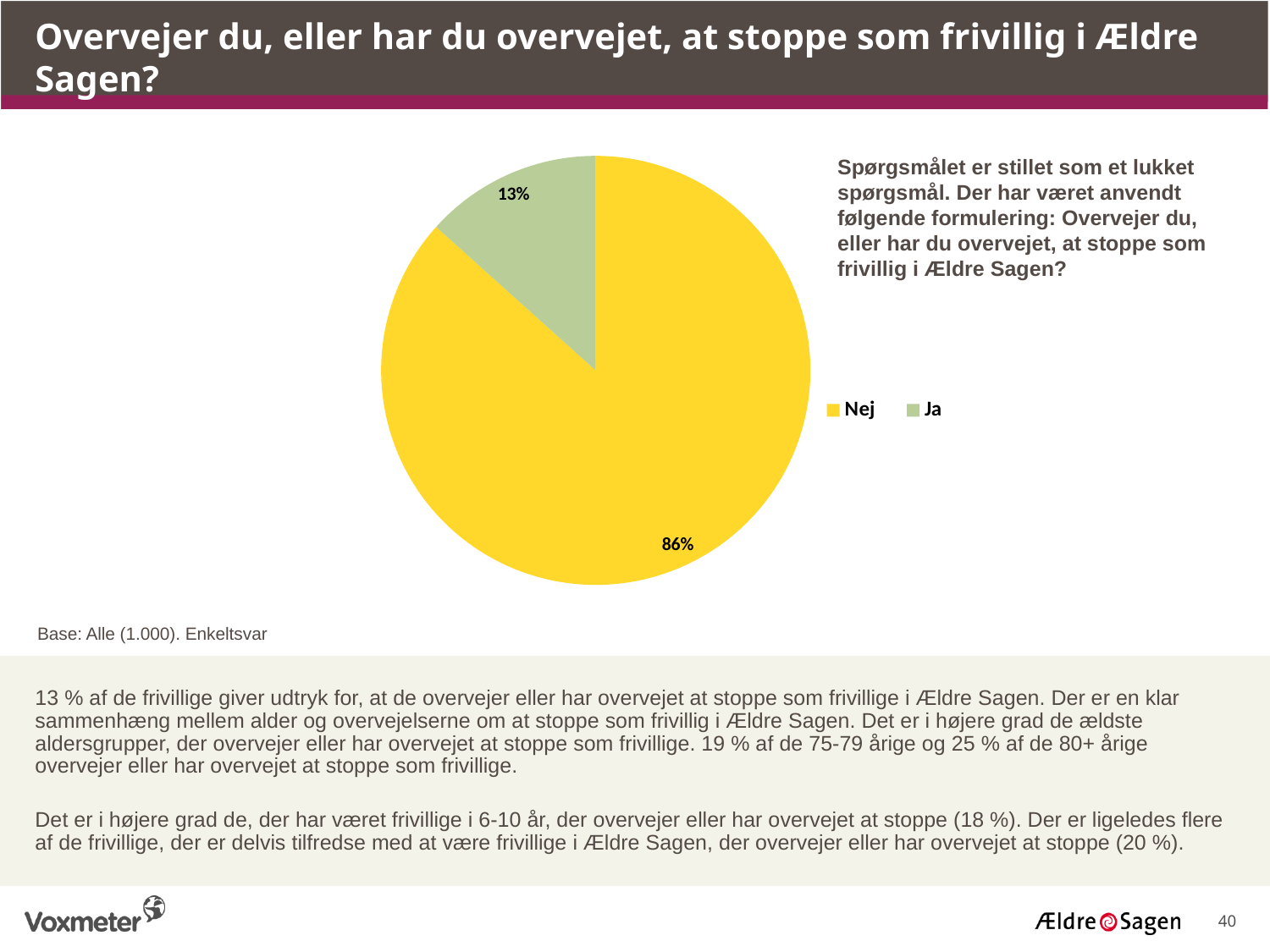
Which slice of the pie is the largest? Nej What share of the pie does the "Nej" slice represent? 86% Which slice of the pie is the smallest? Ja What is the difference in percentage points between the "Nej" and "Ja" slices? 73 Which is larger, the "Ja" slice or the "Nej" slice? Nej How many slices does the pie chart have? 2 How many entries does the legend list? 2 What share of the pie does the "Ja" slice represent? 13% What colour is the "Ja" slice in the pie chart? light green What kind of chart is shown on the slide? pie chart What colour is the "Nej" slice in the pie chart? yellow